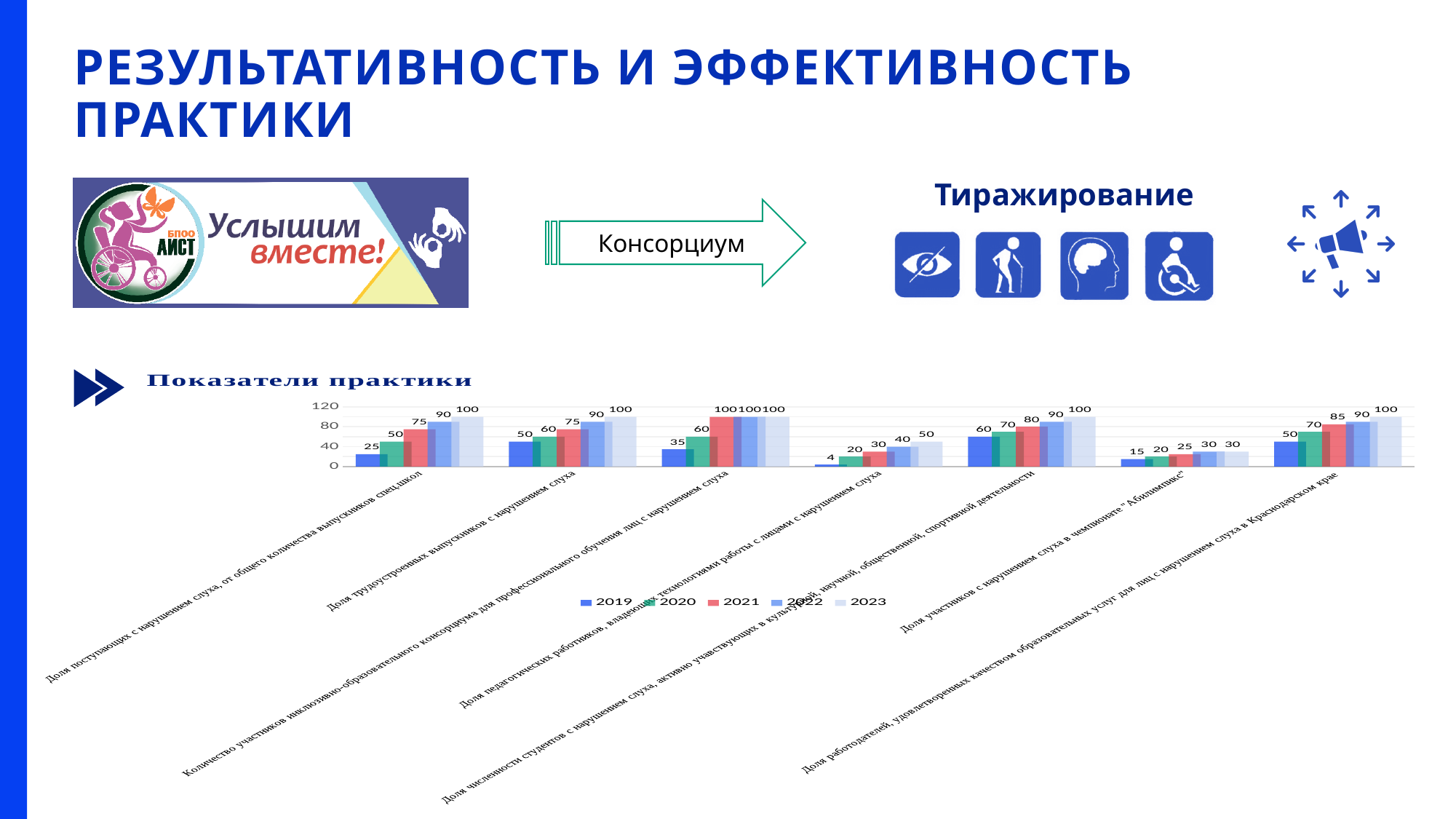
What type of chart is shown under "Показатели практики"? bar chart How many series does the legend of the chart list? 5 How many categories are shown on the x axis of the chart? 7 What is the title shown above the chart? Показатели практики Which year has the lowest value for "Доля трудоустроенных выпускников с нарушением слуха"? 2019 Which is larger: the 2020 value for "Доля численности студентов с нарушением слуха, активно участвующих в культурной, научной, общественной, спортивной деятельности" or the 2020 value for "Доля участников с нарушением слуха в чемпионате "Абилимпикс""? Доля численности студентов с нарушением слуха, активно участвующих в культурной, научной, общественной, спортивной деятельности Do the values for "Доля работодателей, удовлетворенных качеством образовательных услуг для лиц с нарушением слуха в Краснодарском крае" rise or fall from 2019 to 2023? rise What is the 2023 value for "Доля участников с нарушением слуха в чемпионате "Абилимпикс""? 30 What is the 2019 value for "Доля поступающих с нарушением слуха, от общего количества выпускников спецшкол"? 25 What is the 2021 value for "Доля работодателей, удовлетворенных качеством образовательных услуг для лиц с нарушением слуха в Краснодарском крае"? 85 What is the 2019 value for "Доля педагогических работников, владеющих технологиями работы с лицами с нарушением слуха"? 4 What is the difference between the 2023 and 2019 values for "Доля поступающих с нарушением слуха, от общего количества выпускников спецшкол"? 75